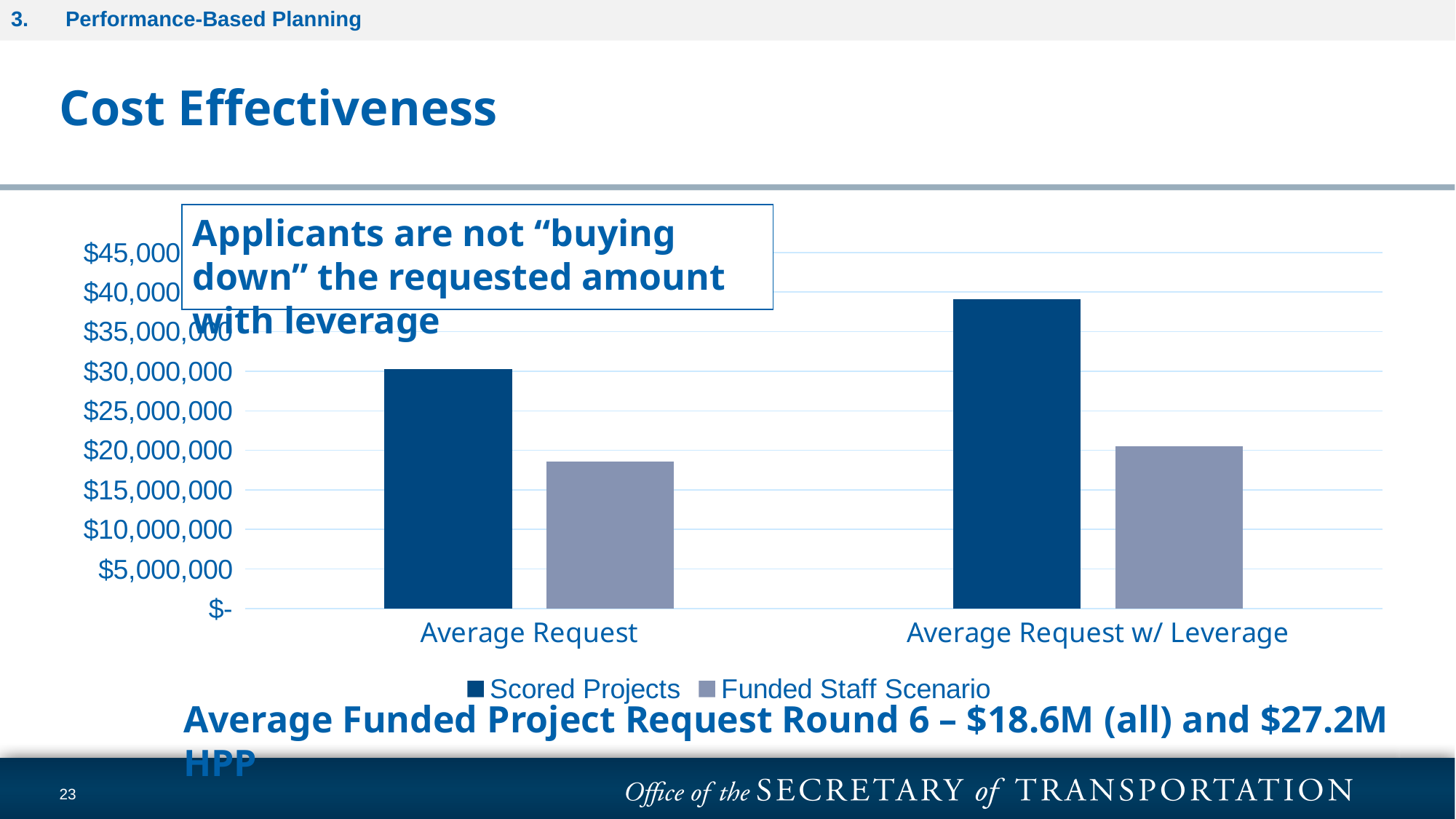
Which bar in the chart is the tallest? Scored Projects, Average Request w/ Leverage For Average Request w/ Leverage, which series has the larger value, Scored Projects or Funded Staff Scenario? Scored Projects How many categories are shown on the x axis of the chart? 2 What kind of chart is shown on the slide? bar chart Is the Funded Staff Scenario value for Average Request w/ Leverage greater or less than $15,000,000? greater Is the Scored Projects value for Average Request greater or less than $25,000,000? greater How many series does the chart legend list? 2 Does the Scored Projects series rise or fall from Average Request to Average Request w/ Leverage? rise Is the Funded Staff Scenario value for Average Request greater or less than $20,000,000? less Which series is shown in dark blue in the chart legend? Scored Projects Which bar in the chart is the shortest? Funded Staff Scenario, Average Request